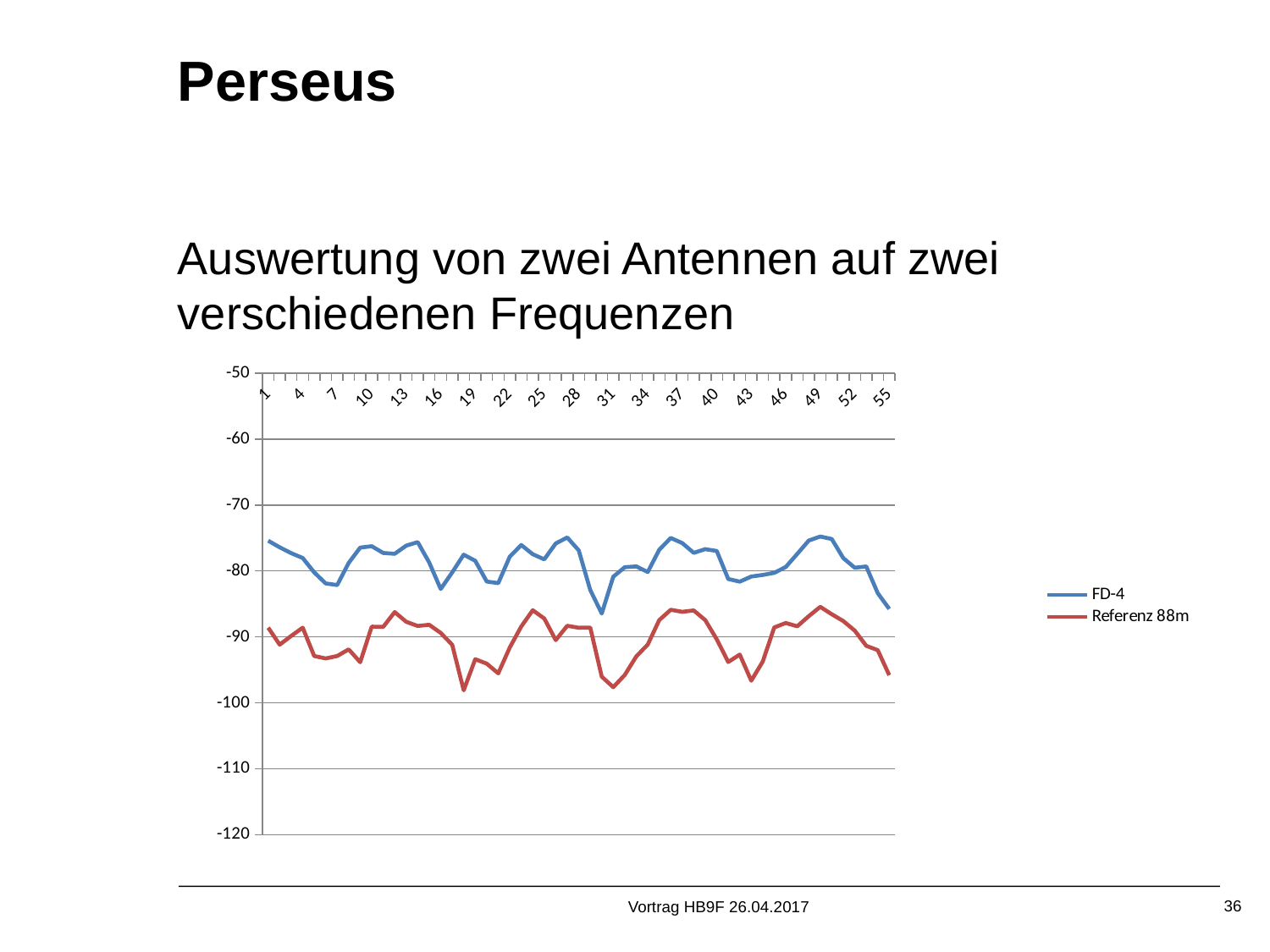
Is the value of FD-4 at x = 1 greater or less than -80? greater At x = 1, which series has the larger value, FD-4 or Referenz 88m? FD-4 What are the names of the two series in the legend? FD-4 and Referenz 88m Which series has the higher values across the chart, FD-4 or Referenz 88m? FD-4 Which colour is used for the Referenz 88m series? red Is the value of Referenz 88m at x = 1 greater or less than -80? less What is the highest x-axis label shown on the chart? 55 Is the value of FD-4 at x = 49 greater or less than -80? greater What kind of chart is shown on the slide? line chart How many series does the legend list? 2